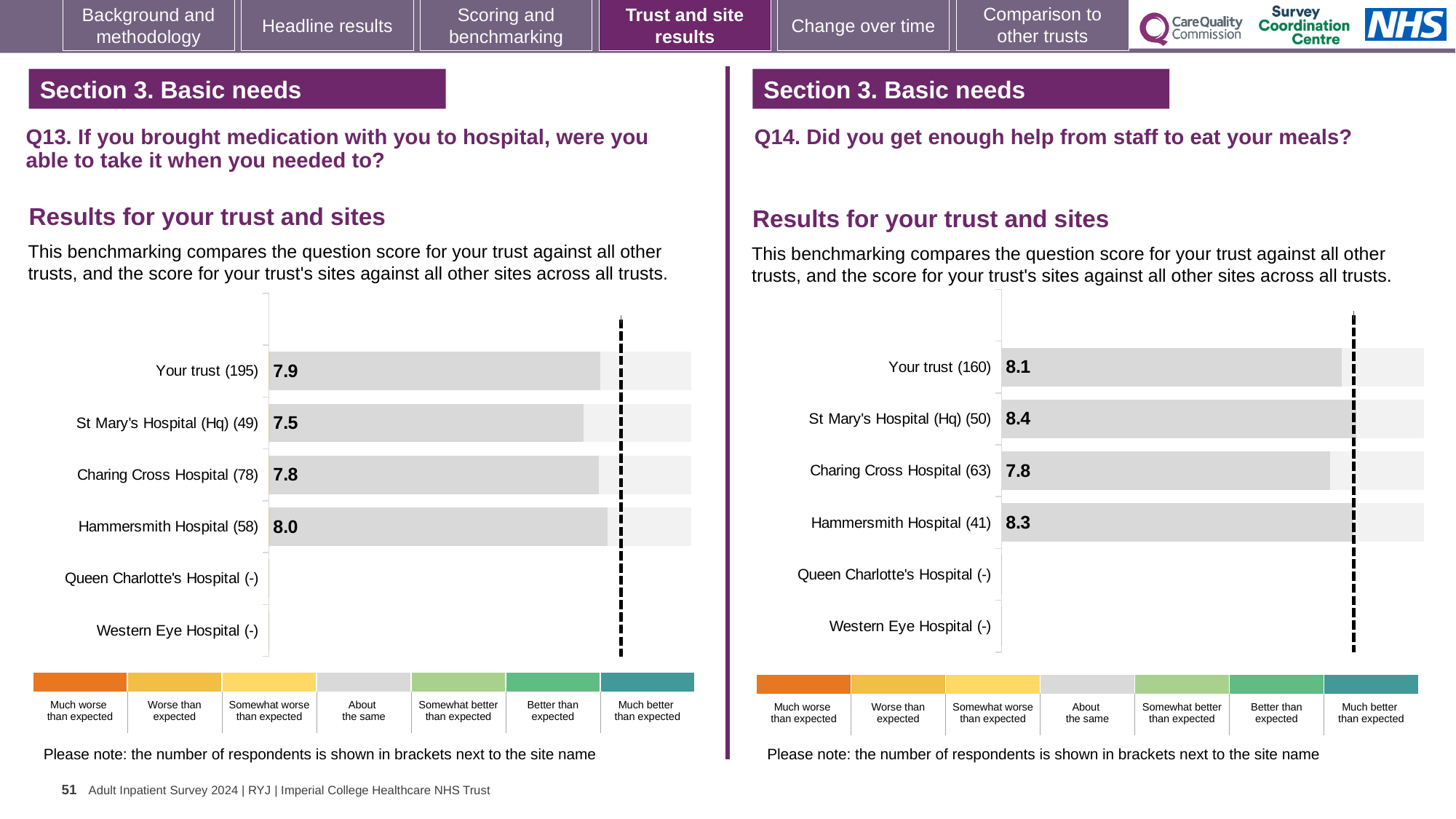
What kind of chart is used for the Q14 results on the right? Bar chart In the Q13 chart on the left, what is the difference between the scores for Hammersmith Hospital and St Mary's Hospital (Hq)? 0.5 In the Q14 chart on the right, what is the difference between the scores for St Mary's Hospital (Hq) and Charing Cross Hospital? 0.6 In the Q14 chart on the right, what is the score for Hammersmith Hospital? 8.3 In the Q14 chart on the right, which site with a plotted score has the highest value? St Mary's Hospital (Hq) In the Q13 chart on the left, which site with a plotted score has the highest value? Hammersmith Hospital In the Q14 chart on the right, what is the score for Charing Cross Hospital? 7.8 How many site labels (including Your trust) are listed on the Q13 chart on the left? 6 In the Q13 chart on the left, what is the score for St Mary's Hospital (Hq)? 7.5 In the Q14 chart on the right, is the score for Your trust or for St Mary's Hospital (Hq) larger? St Mary's Hospital (Hq) In the Q13 chart on the left, what is the score for Your trust? 7.9 In the Q13 chart on the left, which site with a plotted score has the lowest value? St Mary's Hospital (Hq)